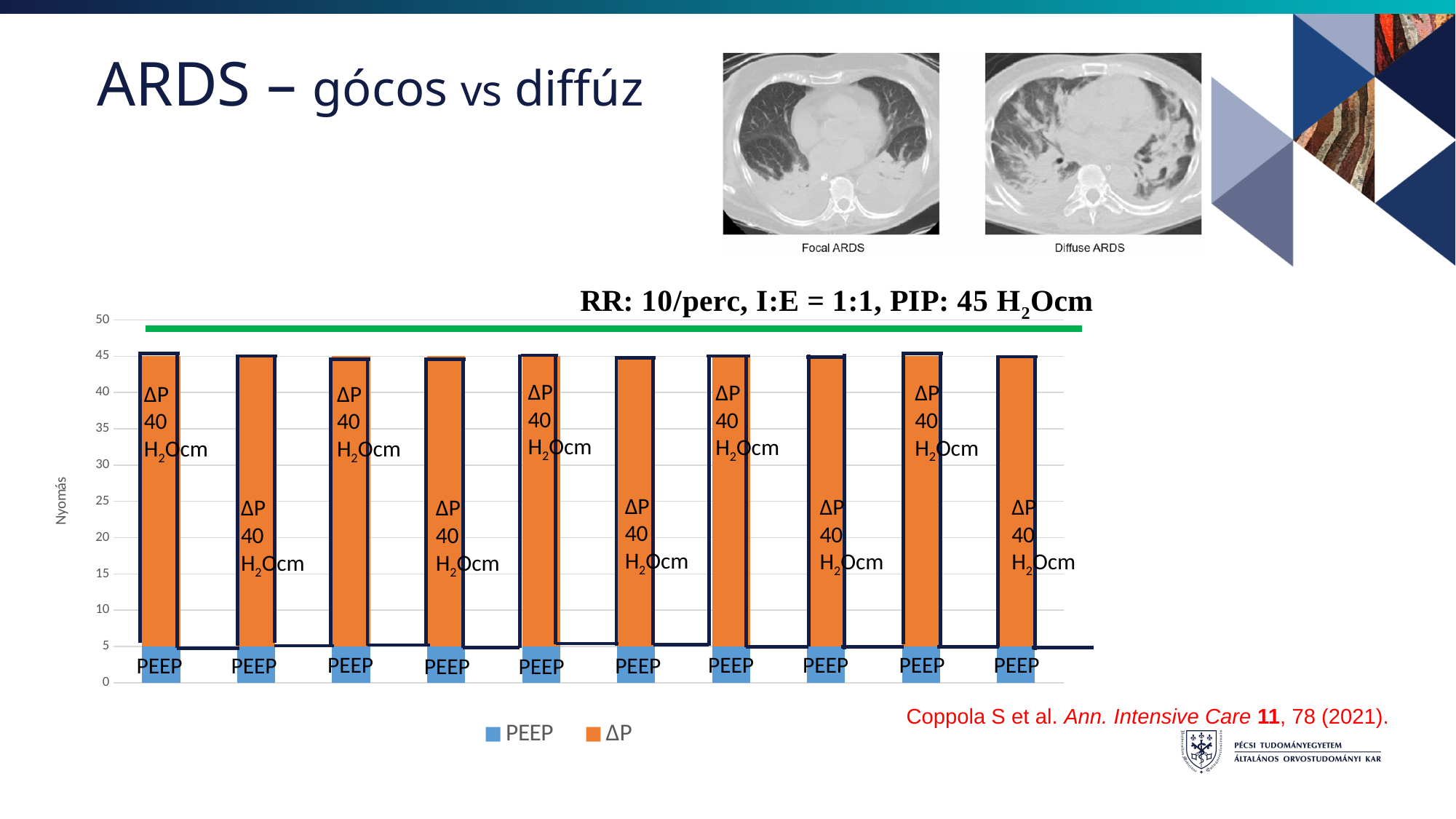
Is the PEEP value in each bar greater or less than 10? less How many bars are plotted in the chart? 10 What kind of chart is shown on the slide? bar chart How many series does the chart legend list? 2 Do the ΔP values rise, fall, or stay the same across the bars from left to right? stay the same What is the label of the vertical axis? Nyomás What are the two series named in the chart legend? PEEP and ΔP Is the top of each stacked bar greater or less than 40? greater What is the highest value shown on the vertical axis? 50 What is the ΔP value labelled on the first bar? 40 H2Ocm What is the ΔP value labelled on the last bar? 40 H2Ocm